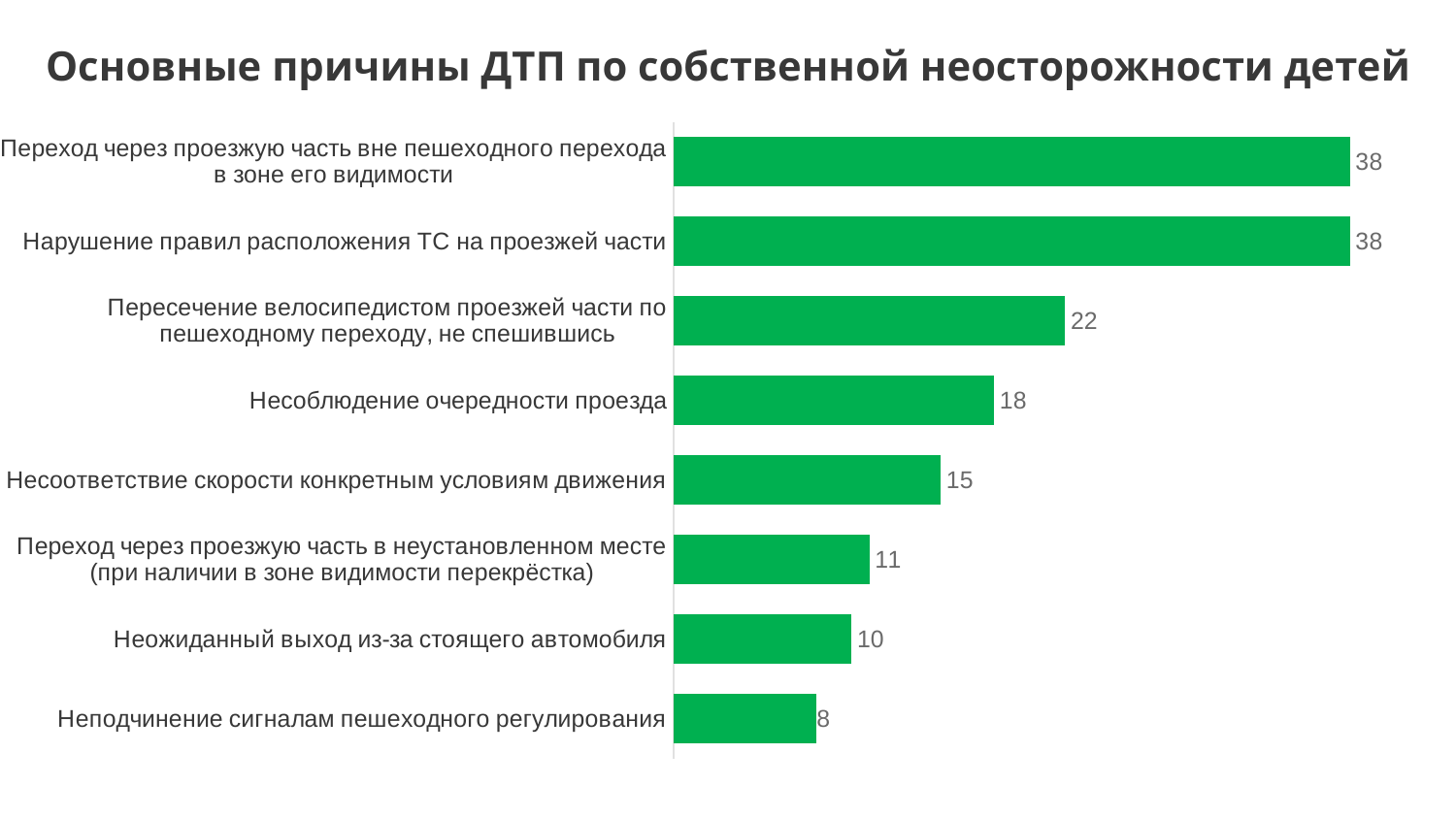
How many categories are shown in the chart? 8 What is the difference between the values for «Неожиданный выход из-за стоящего автомобиля» and «Неподчинение сигналам пешеходного регулирования»? 2 What is the value for «Неожиданный выход из-за стоящего автомобиля»? 10 What is the difference between the values for «Пересечение велосипедистом проезжей части по пешеходному переходу, не спешившись» and «Несоблюдение очередности проезда»? 4 Do the values increase or decrease going from the top bar to the bottom bar? Decrease Which is larger: the value for «Несоответствие скорости конкретным условиям движения» or for «Переход через проезжую часть в неустановленном месте (при наличии в зоне видимости перекрёстка)»? Несоответствие скорости конкретным условиям движения What is the value for «Пересечение велосипедистом проезжей части по пешеходному переходу, не спешившись»? 22 What is the title of the chart? Основные причины ДТП по собственной неосторожности детей What is the value for «Несоблюдение очередности проезда»? 18 What is the value for «Нарушение правил расположения ТС на проезжей части»? 38 What kind of chart is shown on the slide? Bar chart Which category has the lowest value? Неподчинение сигналам пешеходного регулирования